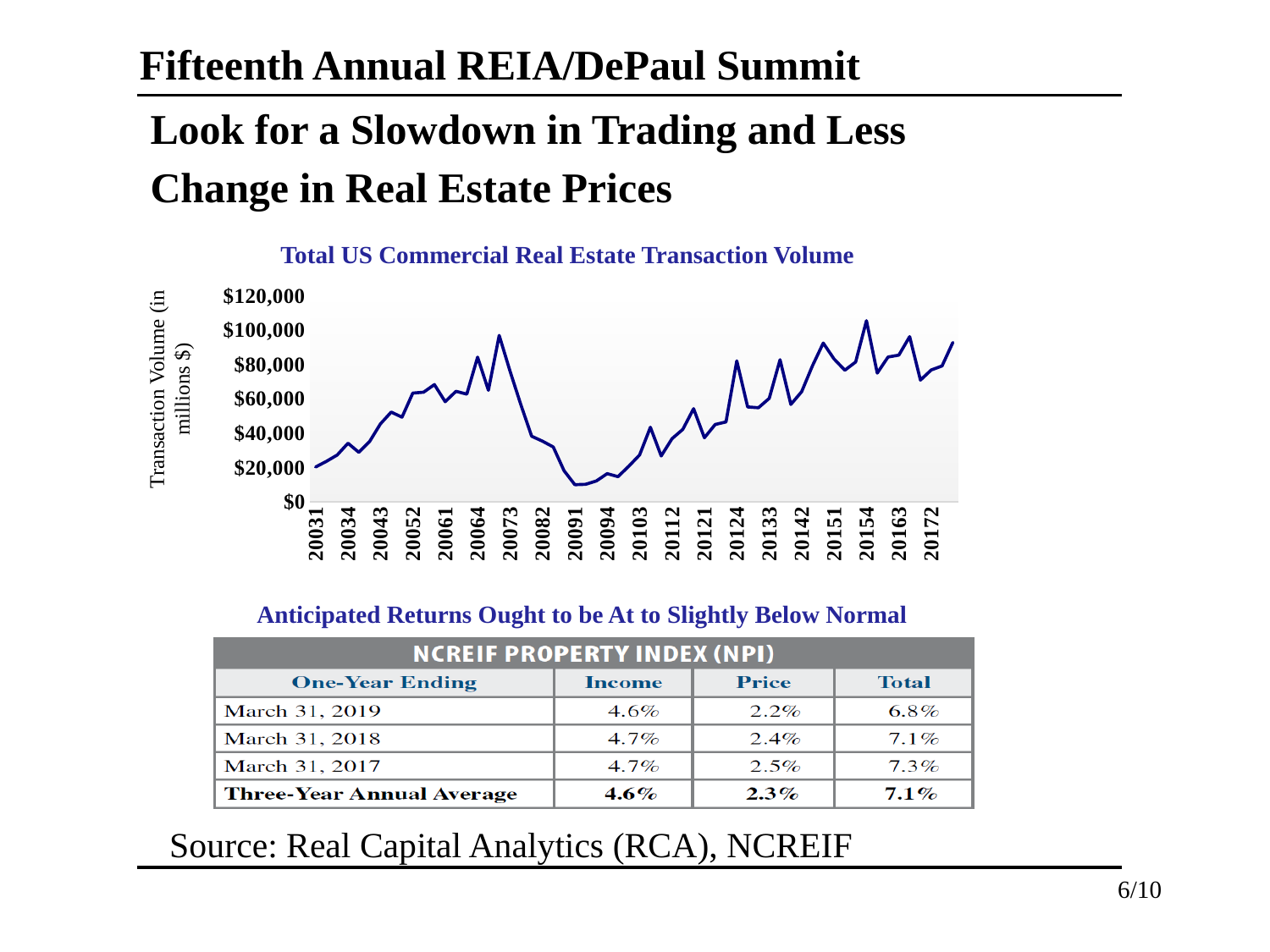
Between 20031 and 20073, does the transaction volume generally rise or fall? rise Is the transaction volume at 20154 greater or less than $80,000? greater How many data series are plotted in the transaction volume chart? 1 Is the transaction volume at 20091 greater or less than $20,000? less What is the title of the chart on the slide? Total US Commercial Real Estate Transaction Volume What is the label on the vertical axis of the transaction volume chart? Transaction Volume (in millions $) Is the transaction volume at 20031 greater or less than $40,000? less Between 20082 and 20091, does the transaction volume rise or fall? fall What kind of chart is used to show Total US Commercial Real Estate Transaction Volume? line chart How many labels are shown along the x axis of the transaction volume chart? 20 Which has the larger transaction volume, 20073 or 20091? 20073